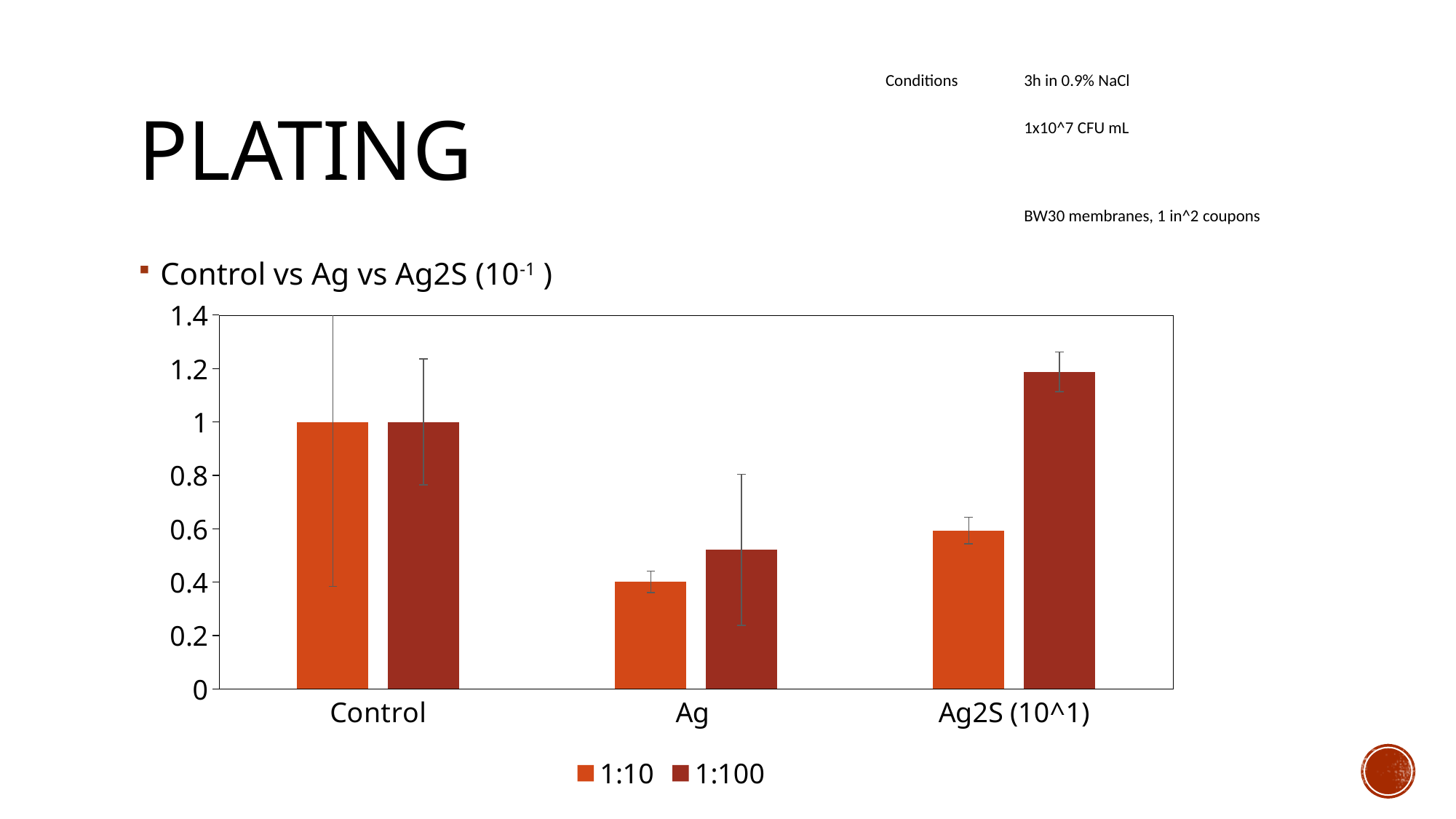
Is the 1:100 value for Ag2S (10^1) greater or less than 1? greater For Ag2S (10^1), which series has the larger bar, 1:10 or 1:100? 1:100 What are the two series named in the chart legend? 1:10 and 1:100 Is the 1:10 value for Ag2S (10^1) greater or less than 0.8? less Is the 1:100 value for Ag greater or less than 0.6? less Which category has the highest 1:100 bar? Ag2S (10^1) What is the value of the 1:10 bar for Control? 1 What type of chart is shown on the slide? bar chart How many categories are shown on the x axis of the chart? 3 How many series does the chart legend list? 2 Which category has the lowest 1:10 bar? Ag What is the value of the 1:100 bar for Control? 1